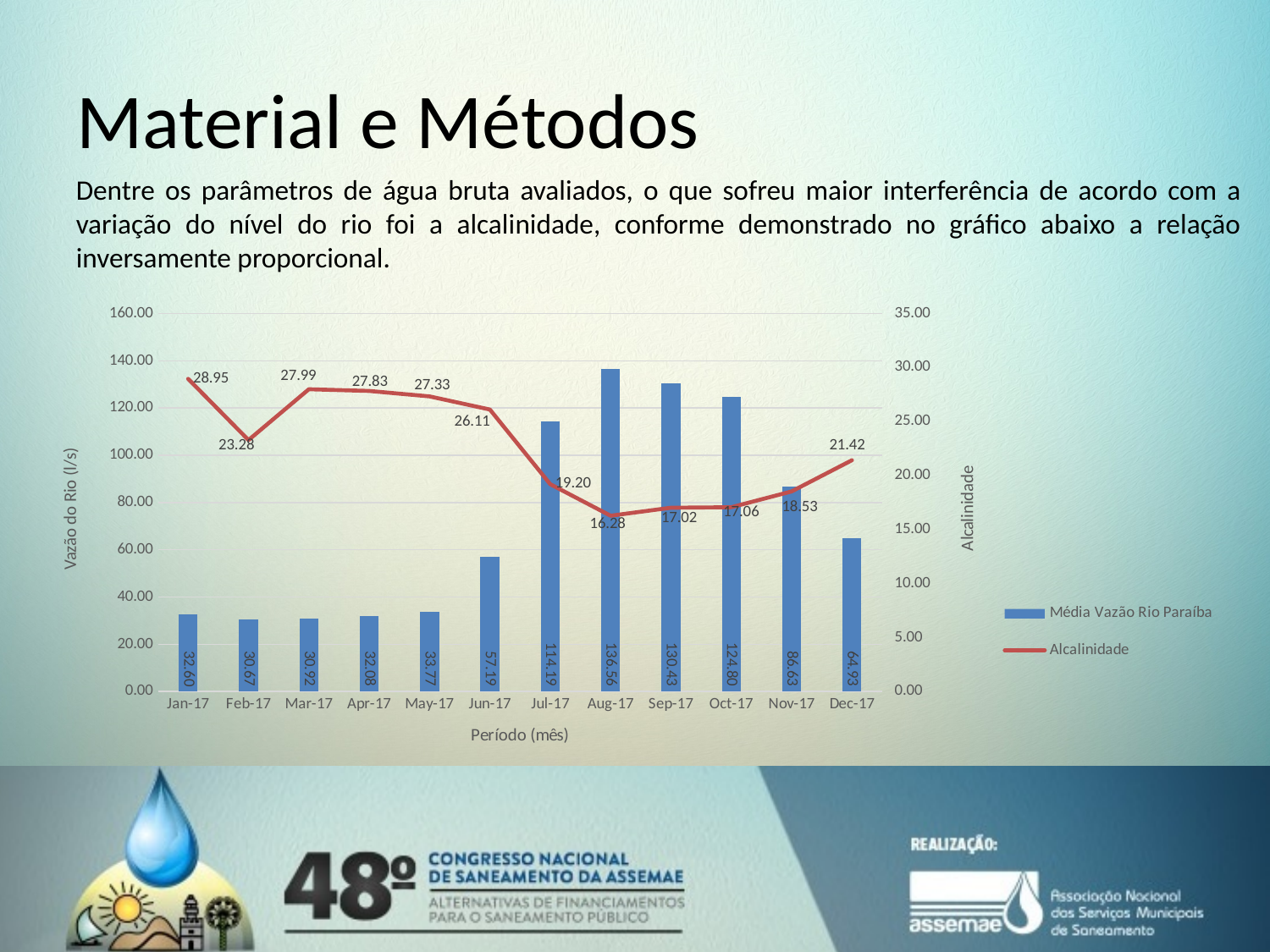
What is the Alcalinidade value for Dec-17? 21.42 Which month has the lowest Alcalinidade? Aug-17 How many series does the legend list? 2 Which month has the highest Média Vazão Rio Paraíba? Aug-17 What is the label of the left vertical axis? Vazão do Rio (l/s) What is the Alcalinidade value for Feb-17? 23.28 What kind of chart is shown on the slide? Combined bar and line chart What is the Média Vazão Rio Paraíba value for Aug-17? 136.56 How many months are shown on the x axis? 12 What is the difference between the Média Vazão Rio Paraíba values for Jul-17 and Jun-17? 57.00 Which month has the highest Alcalinidade? Jan-17 Which is larger, the Média Vazão Rio Paraíba for Sep-17 or for Oct-17? Sep-17